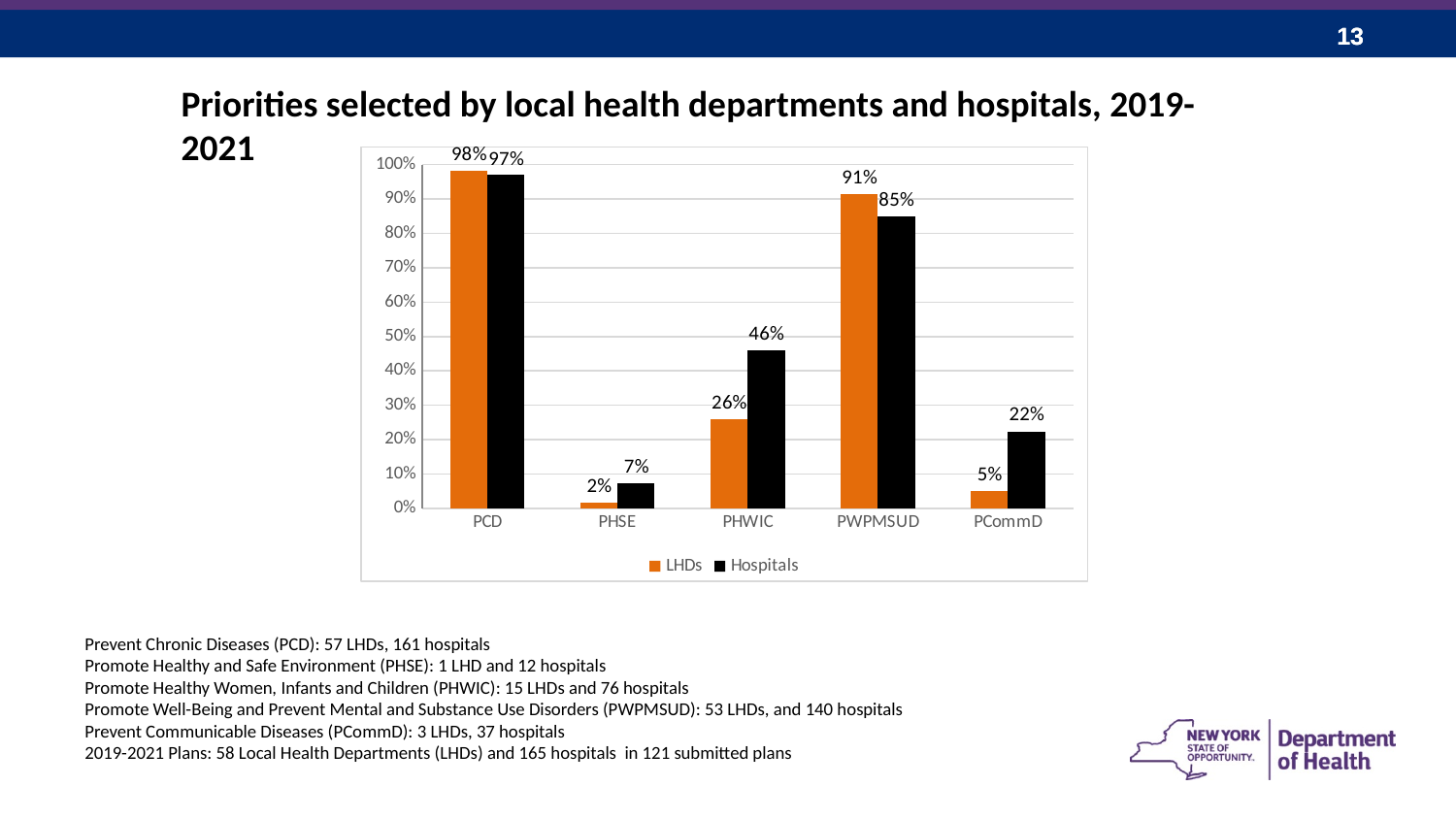
How many series does the legend list? 2 Which colour represents the Hospitals series? Black What is the difference between the LHDs and Hospitals values in the PWPMSUD category? 6% What is the value for LHDs in the PCD category? 98% What kind of chart is shown on the slide? Bar chart Which category has the highest value for Hospitals? PCD How many categories are shown on the x axis? 5 What is the value for LHDs in the PCommD category? 5% Which category has the lowest value for LHDs? PHSE What is the difference between the Hospitals and LHDs values in the PHWIC category? 20% Which is larger in the PCommD category, the LHDs value or the Hospitals value? Hospitals What is the value for Hospitals in the PHWIC category? 46%